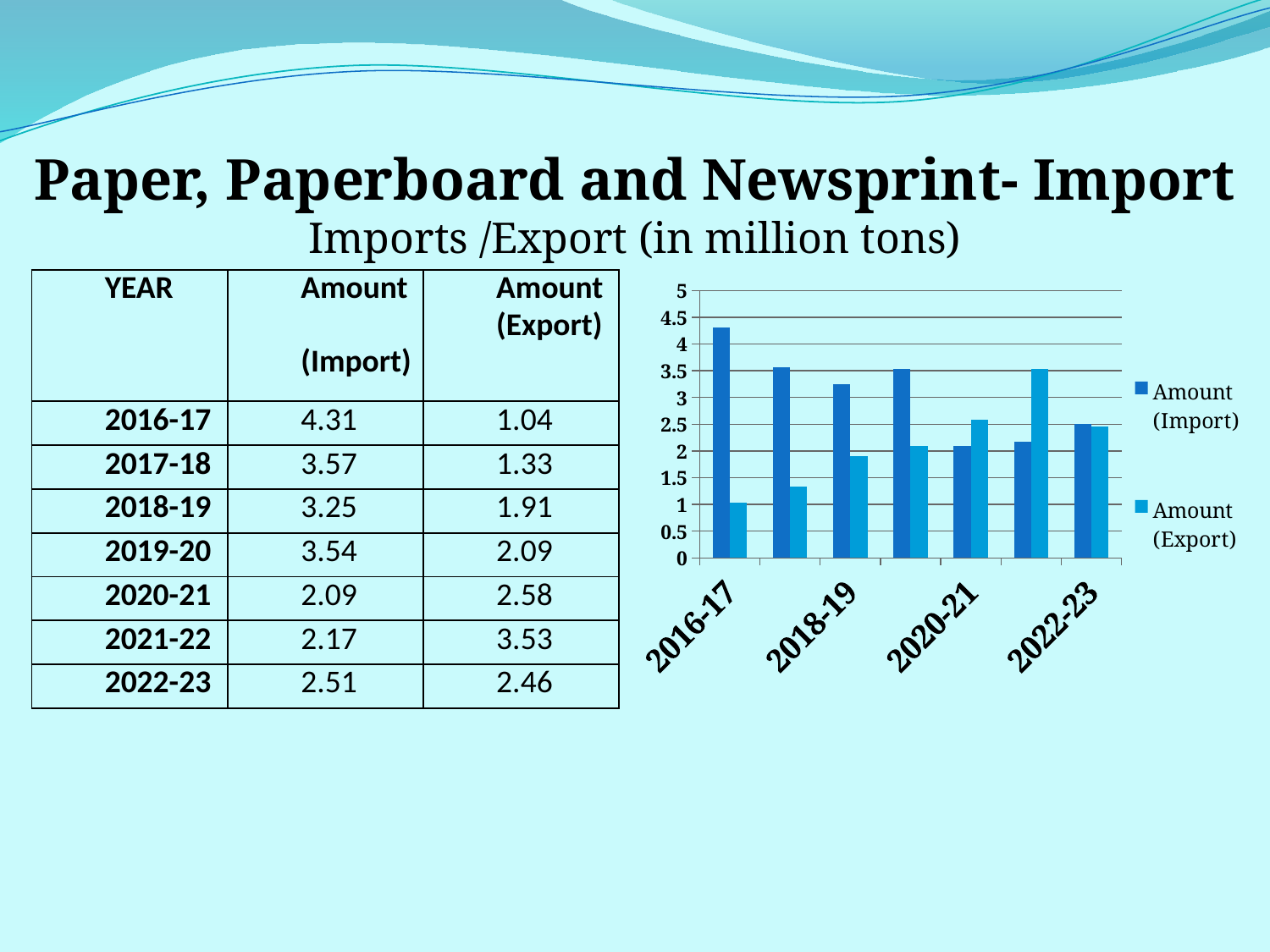
What is the difference between the Amount (Import) and the Amount (Export) in 2016-17? 3.27 How many series does the chart legend list? 2 What is the subtitle shown above the chart and table? Imports /Export (in million tons) How many years are plotted on the x axis of the chart? 7 Which is larger in 2020-21, the Amount (Import) or the Amount (Export)? Amount (Export) Which year has the lowest Amount (Export)? 2016-17 What is the Amount (Export) for 2021-22? 3.53 What kind of chart is shown on the slide? bar chart Is the Amount (Import) for 2017-18 greater or less than 3? greater Does the Amount (Export) generally rise or fall from 2016-17 to 2021-22? rise What is the Amount (Import) for 2016-17? 4.31 Which year has the highest Amount (Import)? 2016-17